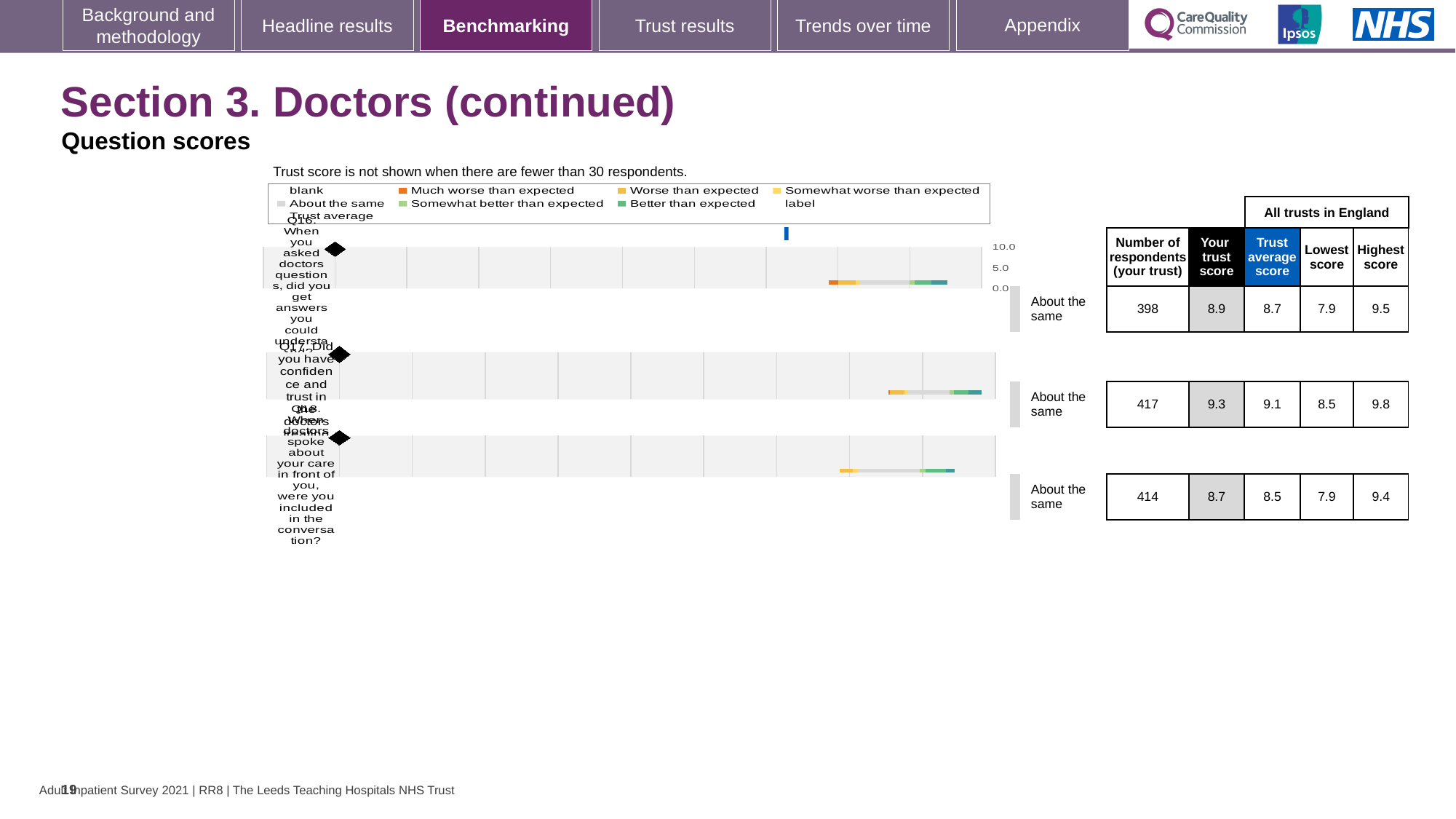
What kind of chart is used to show the question scores? Bar chart For Q16, which is larger: your trust score or the trust average score? Your trust score Which question has the lowest 'Your trust score'? Q18 What is the lowest score across all trusts in England for Q17? 8.5 What is the highest score across all trusts in England for Q18 (included in the conversation)? 9.4 Which question has the highest 'Your trust score'? Q17 What is the difference between the trust score and the trust average score for Q17? 0.2 How many questions are plotted on the chart? 3 What is the 'Your trust score' value for Q17 (confidence and trust in the doctors)? 9.3 What benchmark category is shown for Q18? About the same How many respondents (your trust) are shown for Q16 (answers you could understand)? 398 How many more respondents answered Q17 than Q16? 19